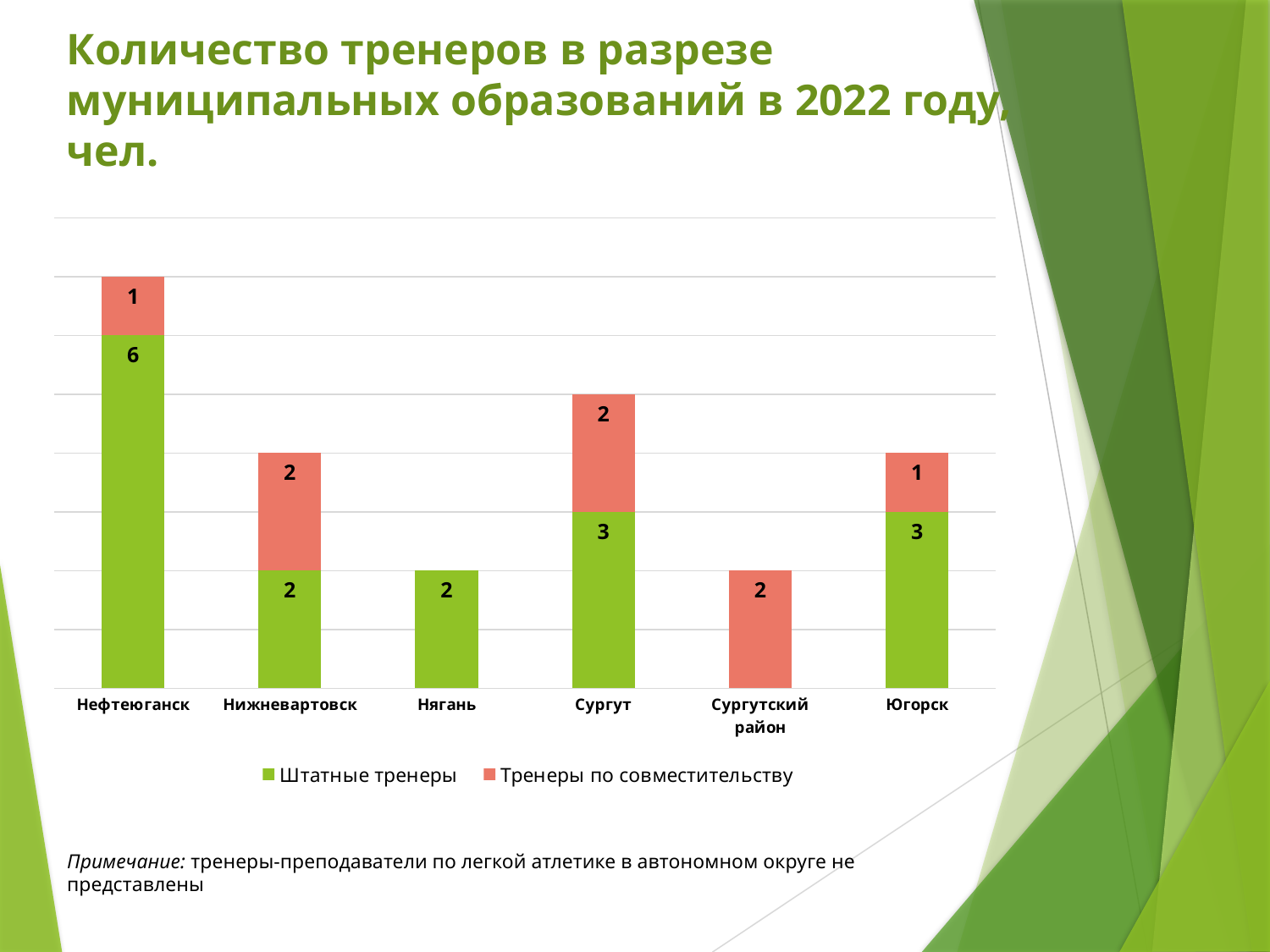
Каково общее количество тренеров в Нижневартовске? 4 Сколько штатных тренеров в Югорске? 3 Сколько штатных тренеров в Нефтеюганске? 6 Сколько тренеров по совместительству в Сургуте? 2 Сколько рядов данных указано в легенде диаграммы? 2 Сколько тренеров по совместительству в Сургутском районе? 2 Где больше штатных тренеров: в Сургуте или в Нягани? Сургут На сколько штатных тренеров в Нефтеюганске больше, чем в Сургуте? 3 В каком муниципальном образовании больше всего штатных тренеров? Нефтеюганск Каково общее количество тренеров в Сургуте (штатные и по совместительству)? 5 Сколько муниципальных образований показано на диаграмме? 6 В каком муниципальном образовании самый высокий общий столбец (больше всего тренеров)? Нефтеюганск